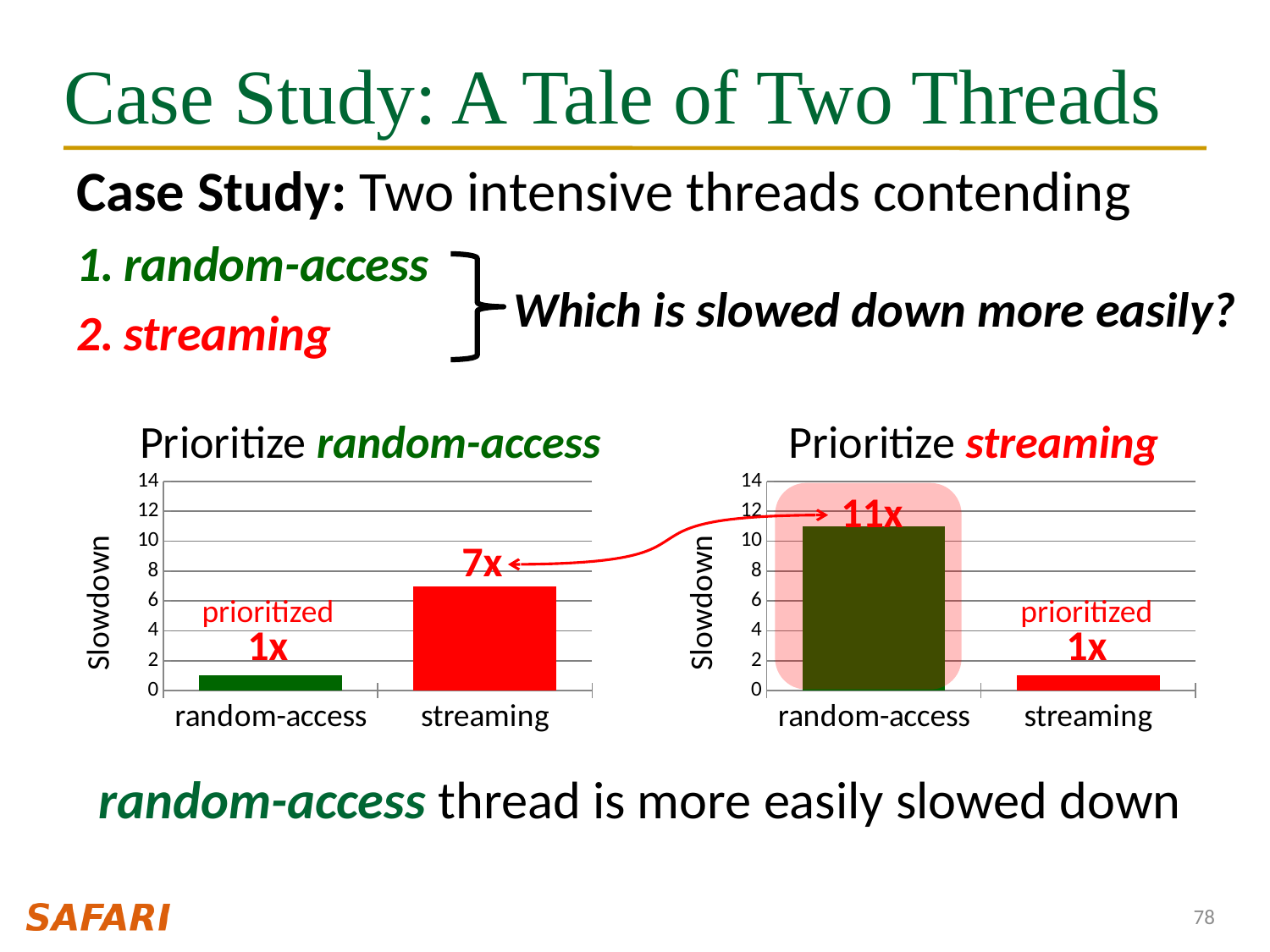
In the 'Prioritize random-access' chart, what is the difference in slowdown between streaming and random-access? 6x In the 'Prioritize streaming' chart, is the value for random-access greater or less than 10? greater What type of chart is the 'Prioritize streaming' chart? Bar chart In the 'Prioritize streaming' chart, what is the slowdown for streaming? 1x Is the slowdown for random-access in the 'Prioritize streaming' chart larger than the slowdown for streaming in the 'Prioritize random-access' chart? Yes In the 'Prioritize random-access' chart, which category has the highest slowdown? streaming How many categories are shown on the x axis of the 'Prioritize random-access' chart? 2 In the 'Prioritize random-access' chart, what is the slowdown for streaming? 7x In the 'Prioritize streaming' chart, what is the difference in slowdown between random-access and streaming? 10x In the 'Prioritize streaming' chart, what is the slowdown for random-access? 11x In the 'Prioritize streaming' chart, which category has the lowest slowdown? streaming In the 'Prioritize random-access' chart, what is the slowdown for random-access? 1x